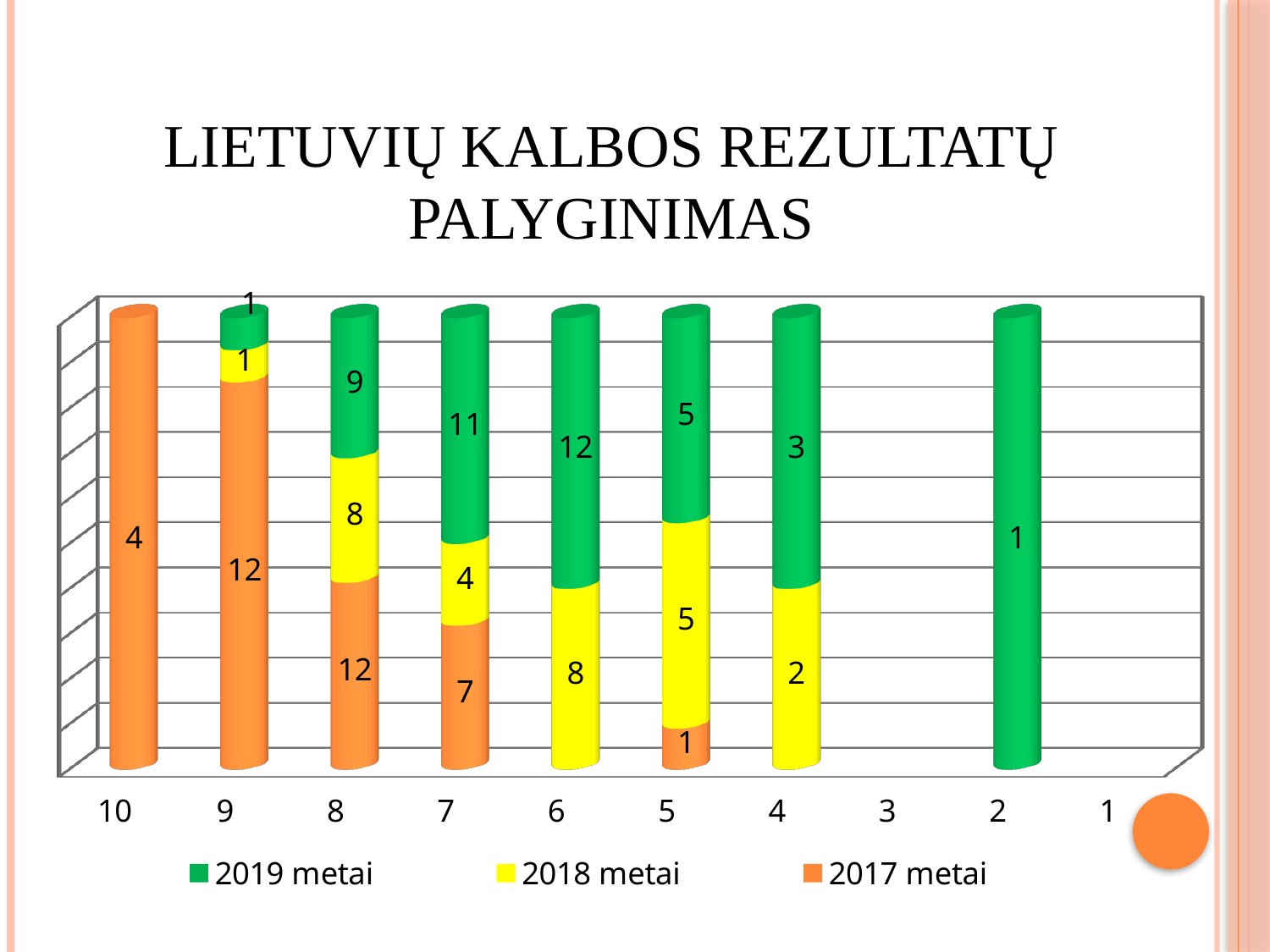
Which category has the lowest labelled value for 2017 metai? 5 How many series does the legend list? 3 What is the value for 2018 metai at category 4? 2 What is the value for 2017 metai at category 10? 4 At category 8, which series has the larger value, 2017 metai or 2018 metai? 2017 metai What is the value for 2017 metai at category 8? 12 What is the value for 2019 metai at category 7? 11 How many categories are shown on the x axis? 10 What kind of chart is shown on the slide? Stacked bar chart Which category has the highest value for 2019 metai? 6 At category 7, what is the difference between the 2019 metai value and the 2018 metai value? 7 What is the sum of the three labelled values in the bar for category 5? 11